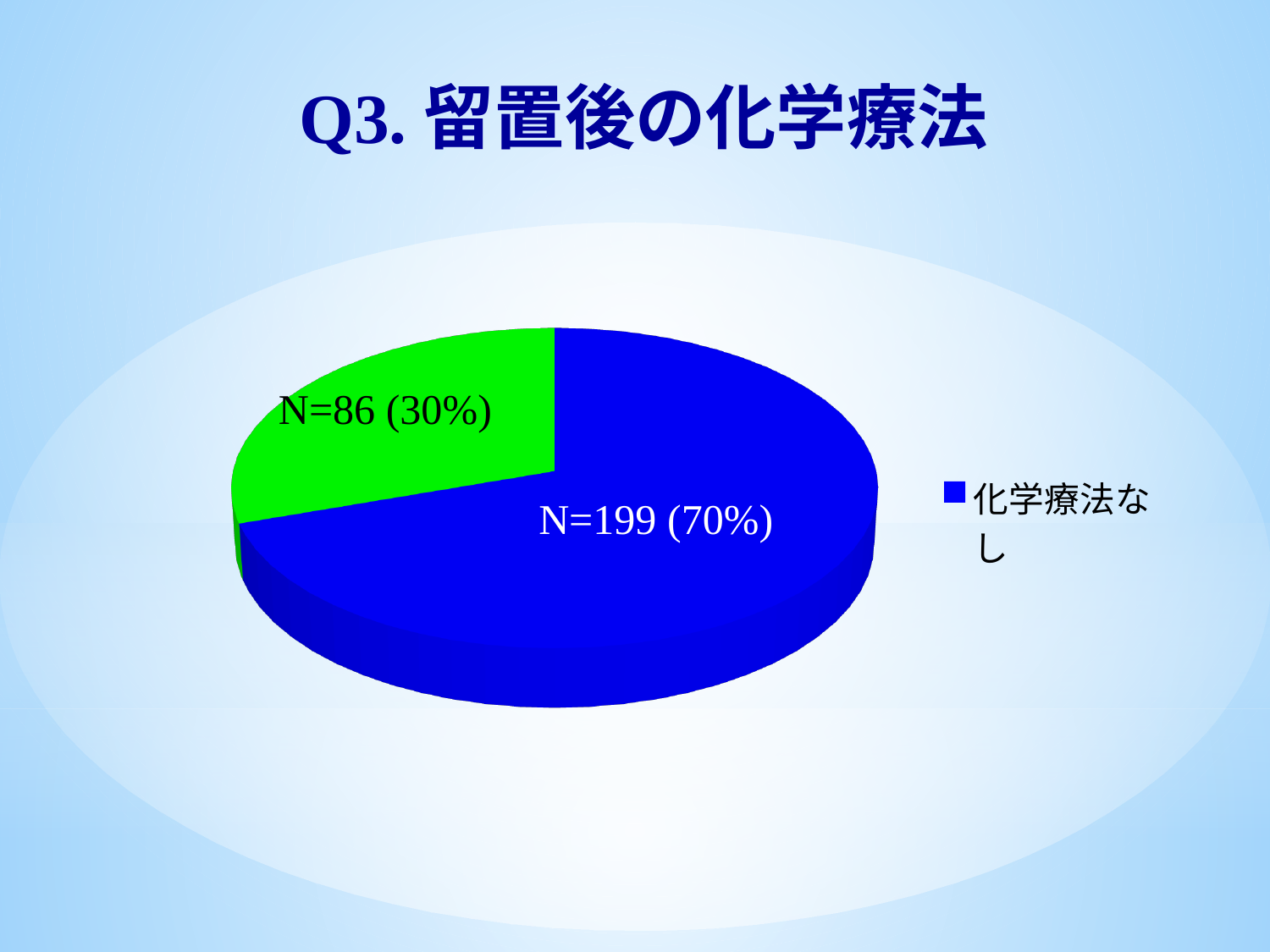
Which slice is the largest in the pie chart? 化学療法なし What is the N value for 化学療法なし? N=199 Which slice is the smallest in the pie chart, by colour? The green slice What is the title of the slide? Q3. 留置後の化学療法 How many entries does the legend list? 1 What is the N value shown on the green slice? N=86 What kind of chart is shown on the slide? Pie chart What is the total N across both slices of the pie chart? 285 What share of the pie does the green slice represent? 30% What is the difference in N between the blue slice and the green slice? 113 What share of the pie does 化学療法なし represent? 70% How many slices does the pie chart have? 2